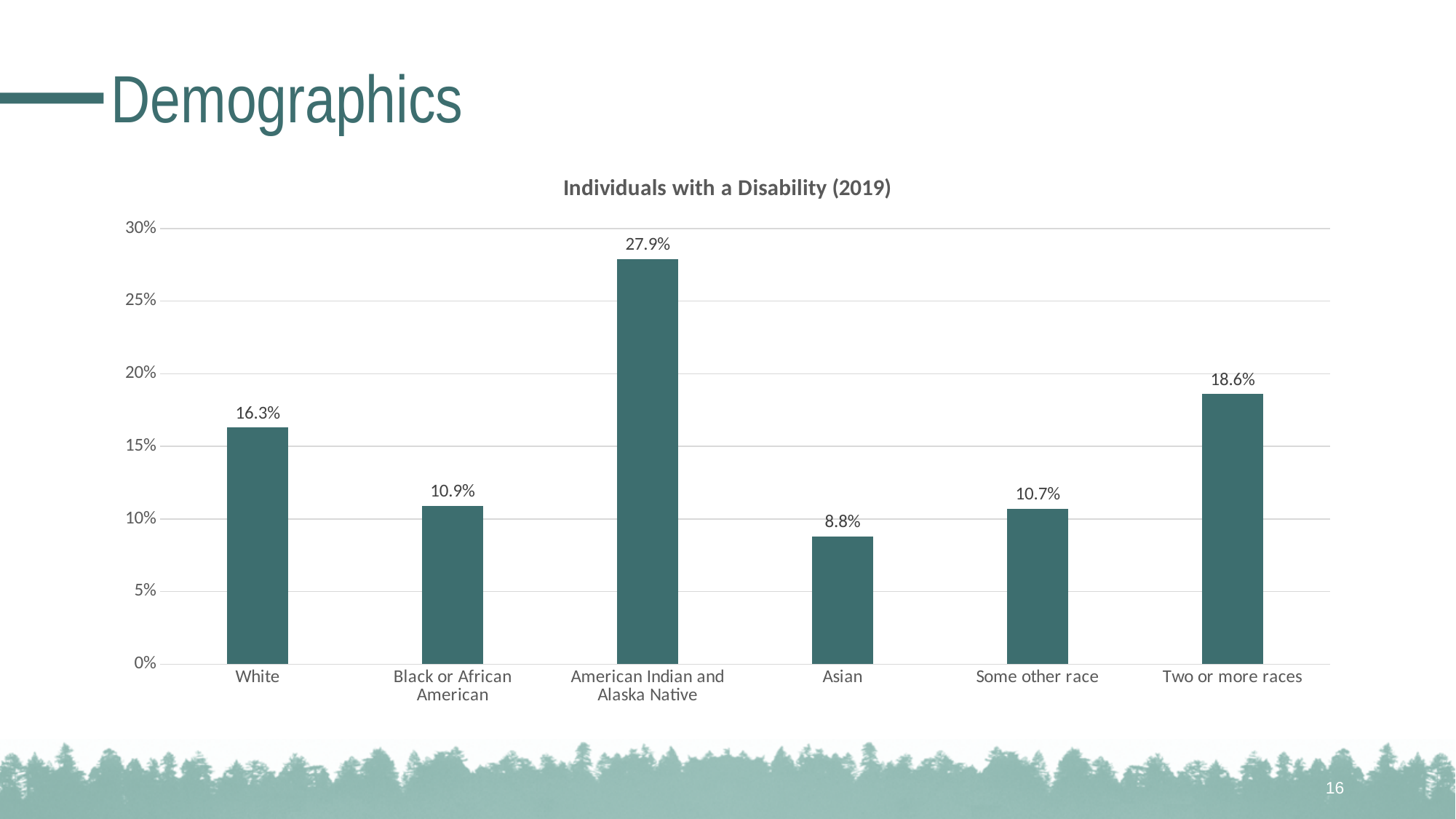
Which category has the lowest value? Asian What is the value for White? 16.3% What is the value for Asian? 8.8% Which is larger, the value for White or the value for Black or African American? White How many categories are shown on the x axis? 6 What is the value for Two or more races? 18.6% Which category has the highest value? American Indian and Alaska Native Is the value for Two or more races greater or less than 20%? less What is the value for American Indian and Alaska Native? 27.9% What is the difference between the values for Two or more races and Some other race? 7.9% What is the difference between the values for American Indian and Alaska Native and White? 11.6% What kind of chart is shown on the slide? bar chart